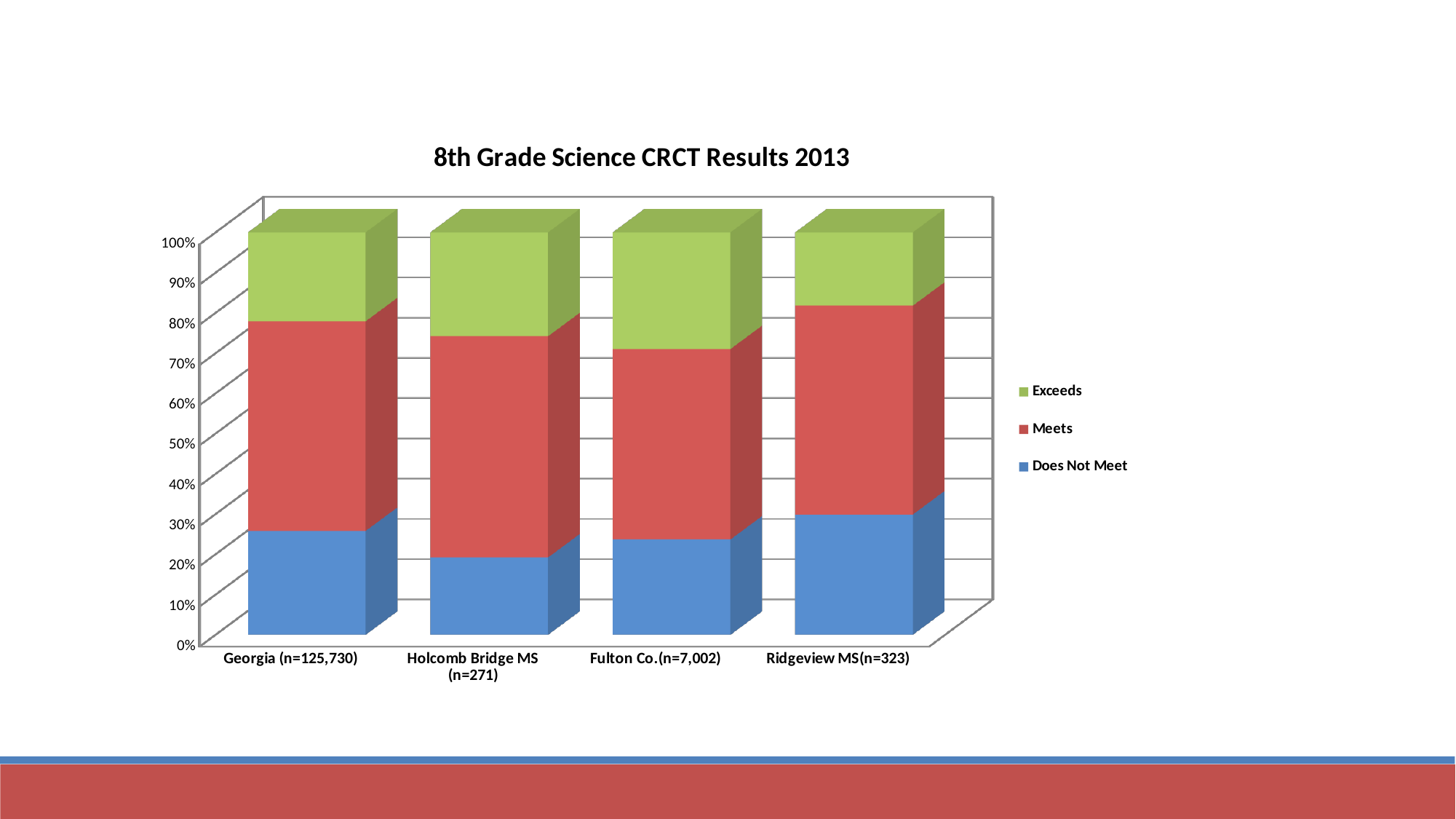
Which category has the largest Does Not Meet share? Ridgeview MS(n=323) Which category has the smallest Does Not Meet share? Holcomb Bridge MS (n=271) Which series is shown in green in the legend? Exceeds Which is larger, the Exceeds share for Holcomb Bridge MS (n=271) or for Ridgeview MS(n=323)? Holcomb Bridge MS (n=271) What kind of chart is shown on the slide? Stacked bar chart Which category has the smallest Exceeds share? Ridgeview MS(n=323) Is the Does Not Meet share for Holcomb Bridge MS (n=271) greater or less than 30%? less How many categories are shown on the x axis? 4 How many series does the legend list? 3 Which is larger, the Does Not Meet share for Georgia (n=125,730) or for Holcomb Bridge MS (n=271)? Georgia (n=125,730) Is the Does Not Meet share for Ridgeview MS(n=323) greater or less than 20%? greater What is the title of the chart? 8th Grade Science CRCT Results 2013